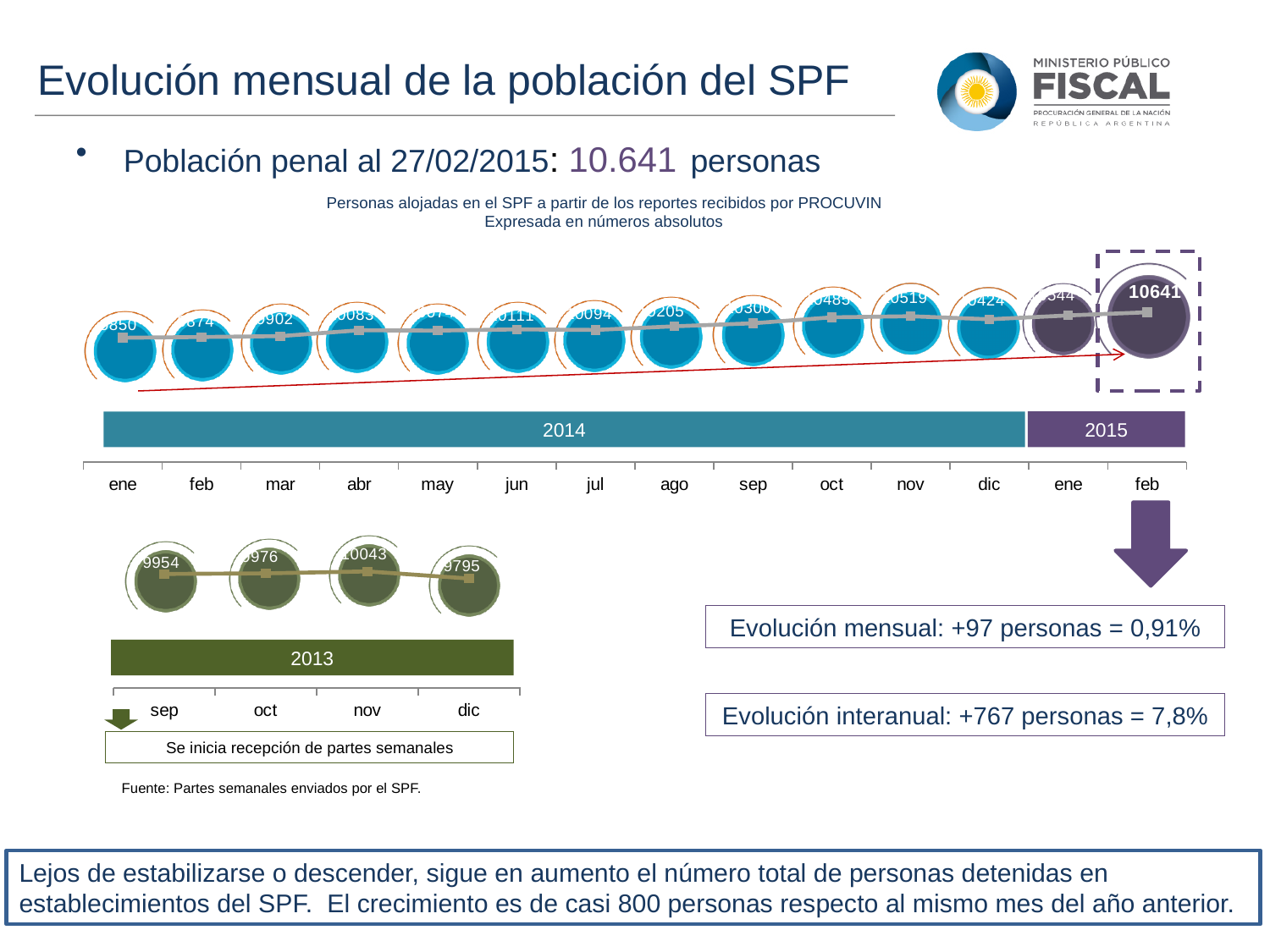
In the 2013 chart, what is the value for nov? 10043 In the 2014–2015 chart, which year is shown with the purple band? 2015 In the 2013 chart, what is the difference between the values for nov and dic? 248 What kind of chart is the 2014–2015 chart? line chart In the 2014–2015 chart, do the values generally rise or fall from ene 2014 to feb 2015? rise In the 2014–2015 chart, what is the value for feb 2015? 10641 How many months are plotted in the 2014–2015 chart? 14 In the 2013 chart, what is the value for dic? 9795 In the 2013 chart, which is larger, the value for sep or the value for oct? oct How many months are plotted in the 2013 chart? 4 In the 2013 chart, which month has the highest value? nov In the 2013 chart, which month has the lowest value? dic